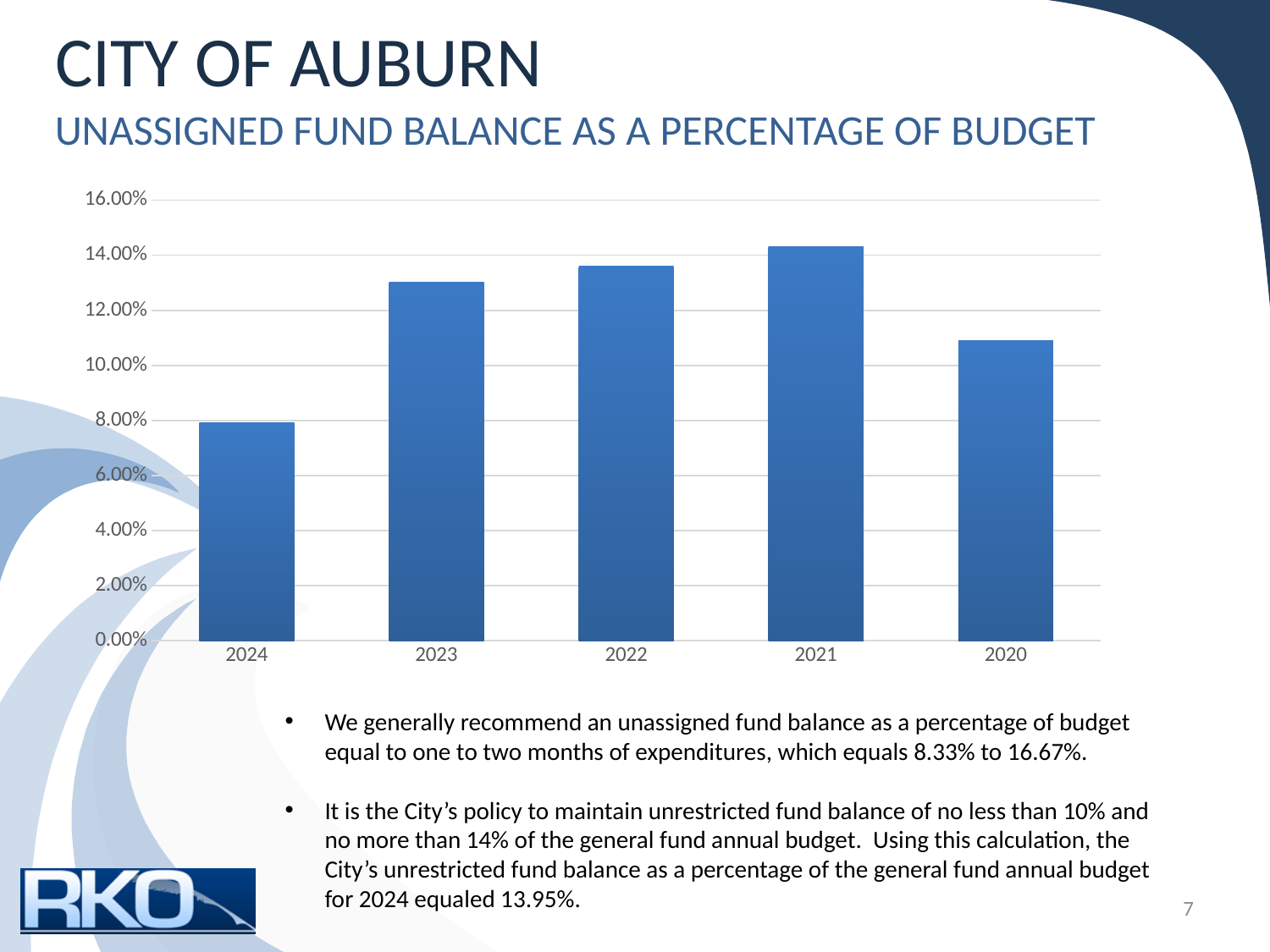
Is the value for 2021 greater or less than 14.00%? greater Which year has the larger value, 2021 or 2020? 2021 Which year has the larger value, 2024 or 2020? 2020 What type of chart is shown on the slide? Bar chart Which year has the highest unassigned fund balance as a percentage of budget? 2021 How many years are shown on the x axis of the chart? 5 What is the highest value shown on the chart's vertical axis? 16.00% Which year has the lowest unassigned fund balance as a percentage of budget? 2024 Is the value for 2022 greater or less than 14.00%? less Is the value for 2020 greater or less than 12.00%? less